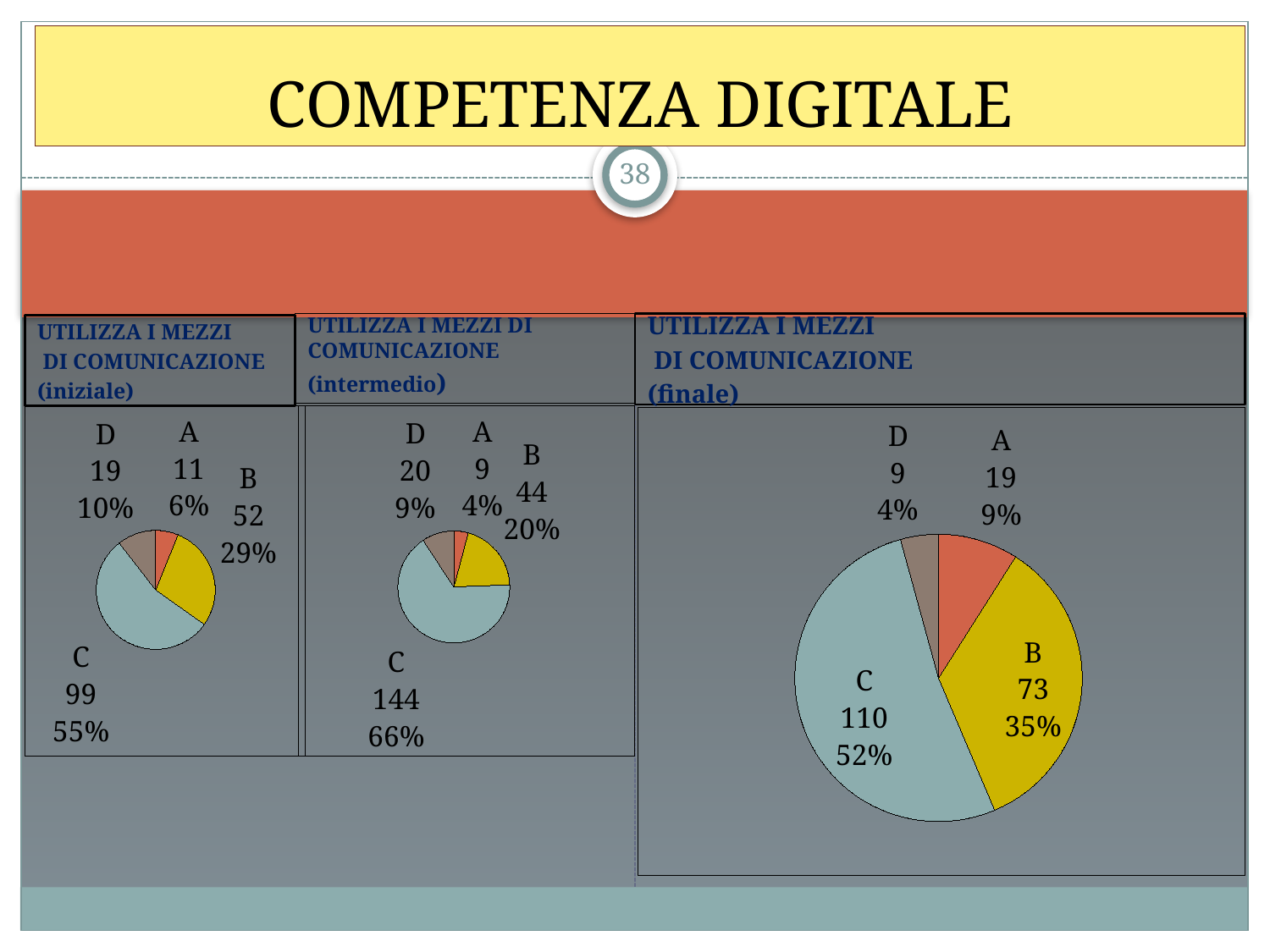
In the 'UTILIZZA I MEZZI DI COMUNICAZIONE (intermedio)' chart, which category has the largest slice? C In the 'UTILIZZA I MEZZI DI COMUNICAZIONE (iniziale)' chart, what is the value for C? 99 In the 'UTILIZZA I MEZZI DI COMUNICAZIONE (finale)' chart, which is larger, the value for A or the value for D? A In the 'UTILIZZA I MEZZI DI COMUNICAZIONE (intermedio)' chart, what is the value for B? 44 In the 'UTILIZZA I MEZZI DI COMUNICAZIONE (finale)' chart, what is the value for B? 73 In the 'UTILIZZA I MEZZI DI COMUNICAZIONE (finale)' chart, what colour is the slice for B? Yellow What kind of chart is the 'UTILIZZA I MEZZI DI COMUNICAZIONE (finale)' chart? Pie chart In the 'UTILIZZA I MEZZI DI COMUNICAZIONE (iniziale)' chart, what percentage share does B have? 29% In the 'UTILIZZA I MEZZI DI COMUNICAZIONE (finale)' chart, what percentage share does C have? 52% In the 'UTILIZZA I MEZZI DI COMUNICAZIONE (finale)' chart, what is the difference between the values for C and B? 37 In the 'UTILIZZA I MEZZI DI COMUNICAZIONE (intermedio)' chart, which category has the smallest slice? A How many categories does the 'UTILIZZA I MEZZI DI COMUNICAZIONE (iniziale)' chart show? 4